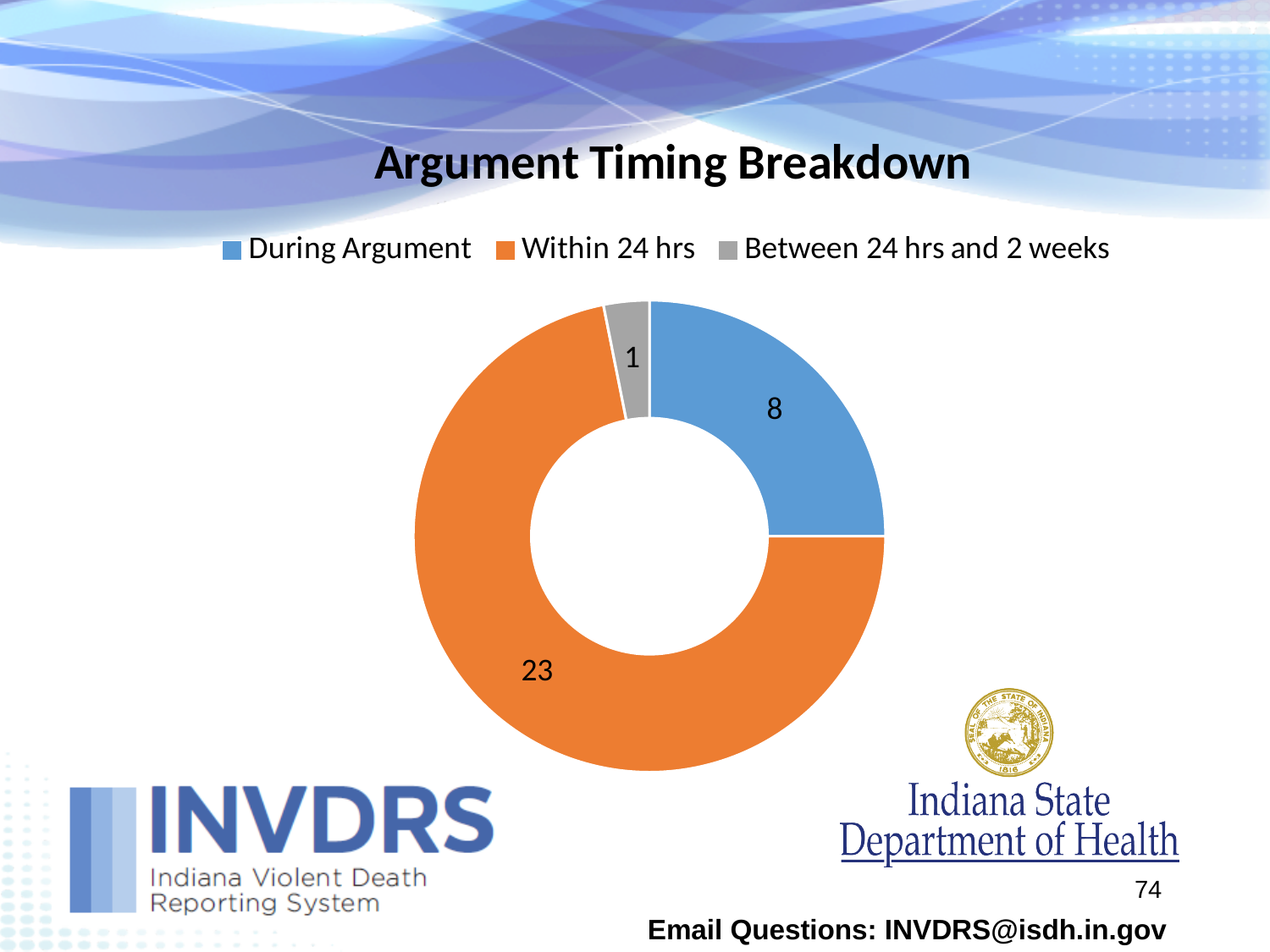
What is the value for During Argument? 8 Which category has the highest value? Within 24 hrs What is the difference between the values for Within 24 hrs and During Argument? 15 What is the total of all the values shown in the chart? 32 What is the value for Between 24 hrs and 2 weeks? 1 How many categories does the chart show? 3 What kind of chart is shown on the slide? Doughnut chart What is the value for Within 24 hrs? 23 What is the title of the chart? Argument Timing Breakdown Which is larger, the value for During Argument or the value for Between 24 hrs and 2 weeks? During Argument How many entries does the legend list? 3 Which category has the lowest value? Between 24 hrs and 2 weeks